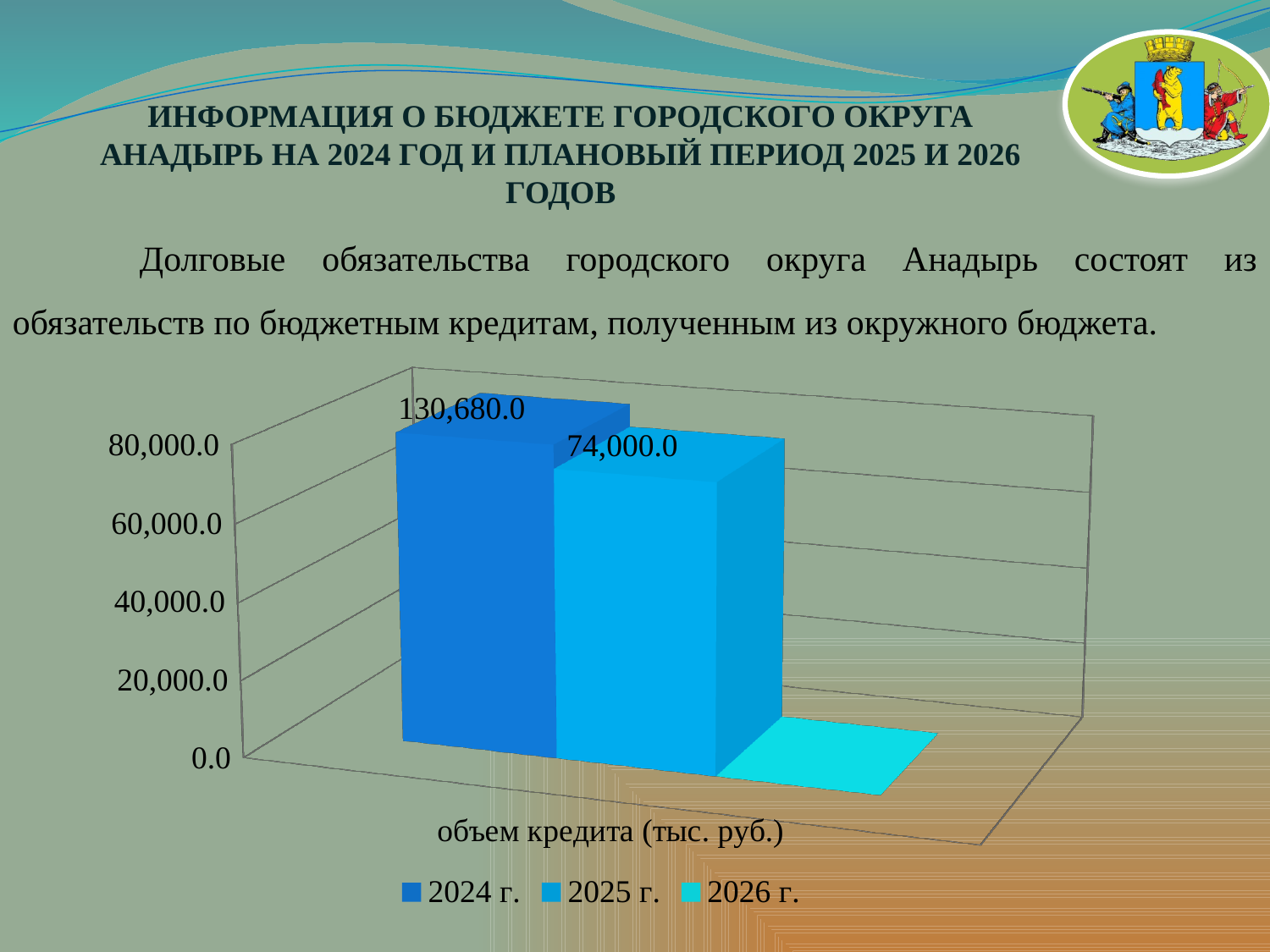
How many series does the legend list? 3 What is the difference between the 2024 г. value and the 2025 г. value? 56,680.0 Which is larger, the value for 2024 г. or the value for 2025 г.? 2024 г. Which series has the highest value in the chart? 2024 г. Which series has the lowest value in the chart? 2026 г. What kind of chart is shown on the slide? bar chart What is the value for the 2024 г. series in the chart? 130,680.0 What is the category label shown under the bars on the x axis? объем кредита (тыс. руб.) Is the value for 2026 г. greater or less than 20,000.0? less What is the value for the 2025 г. series in the chart? 74,000.0 Is the value for 2025 г. greater or less than 60,000.0? greater How many categories are shown on the x axis of the chart? 1